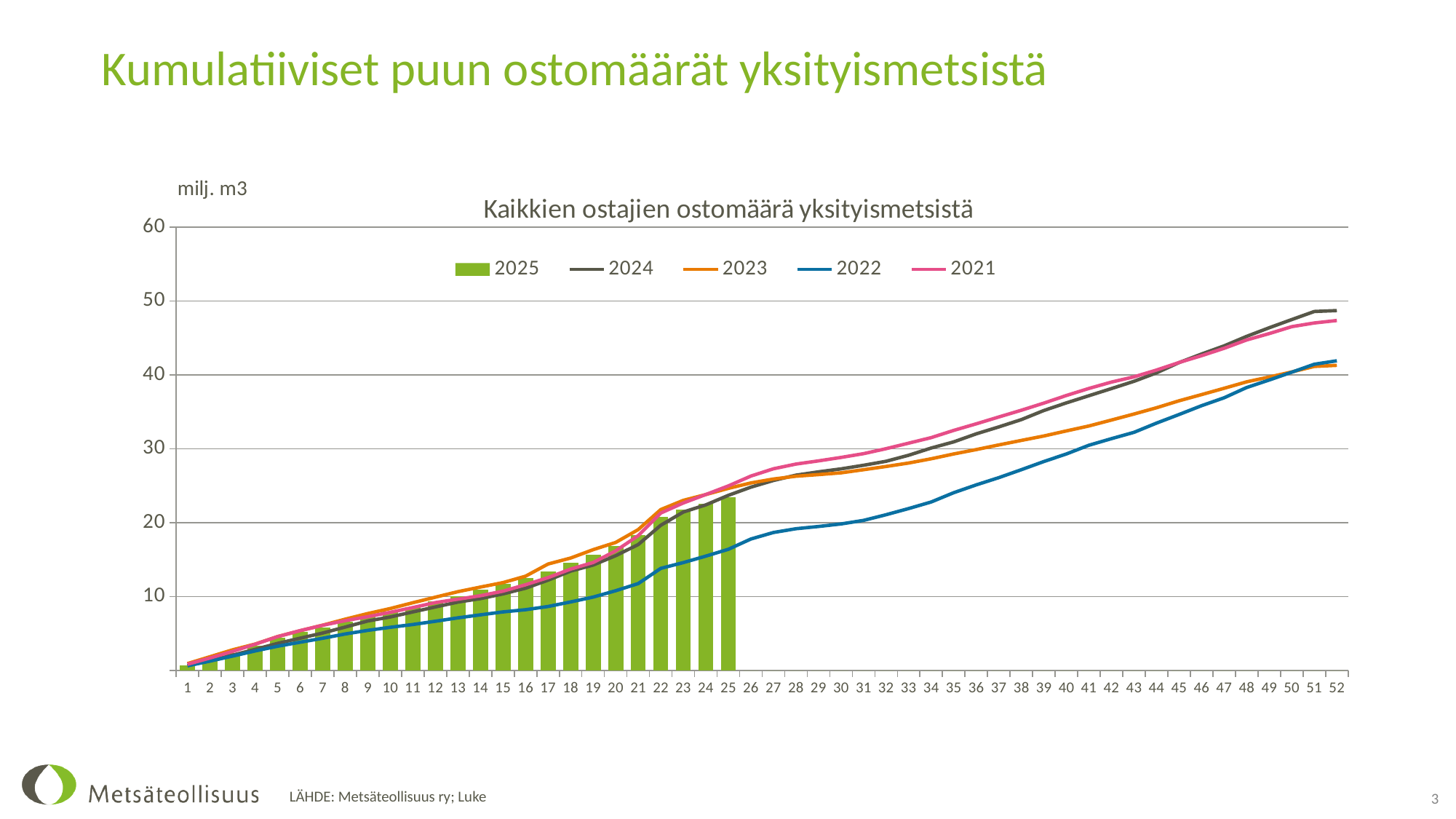
How many week categories are shown on the x axis? 52 Do the values of the 2024 line rise or fall along the x axis? Rise Up to which week do the 2025 bars extend? 25 Is the value for 2025 at week 25 greater or less than 20? greater Which series has the lowest value at week 40? 2022 At week 52, which is larger, the value for 2024 or the value for 2022? 2024 Is the value for 2024 at week 52 greater or less than 50? less How many series does the legend list? 5 Is the value for 2024 at week 40 greater or less than 30? greater What kind of chart is shown on the slide? A combined bar and line chart What is the title of the chart? Kaikkien ostajien ostomäärä yksityismetsistä